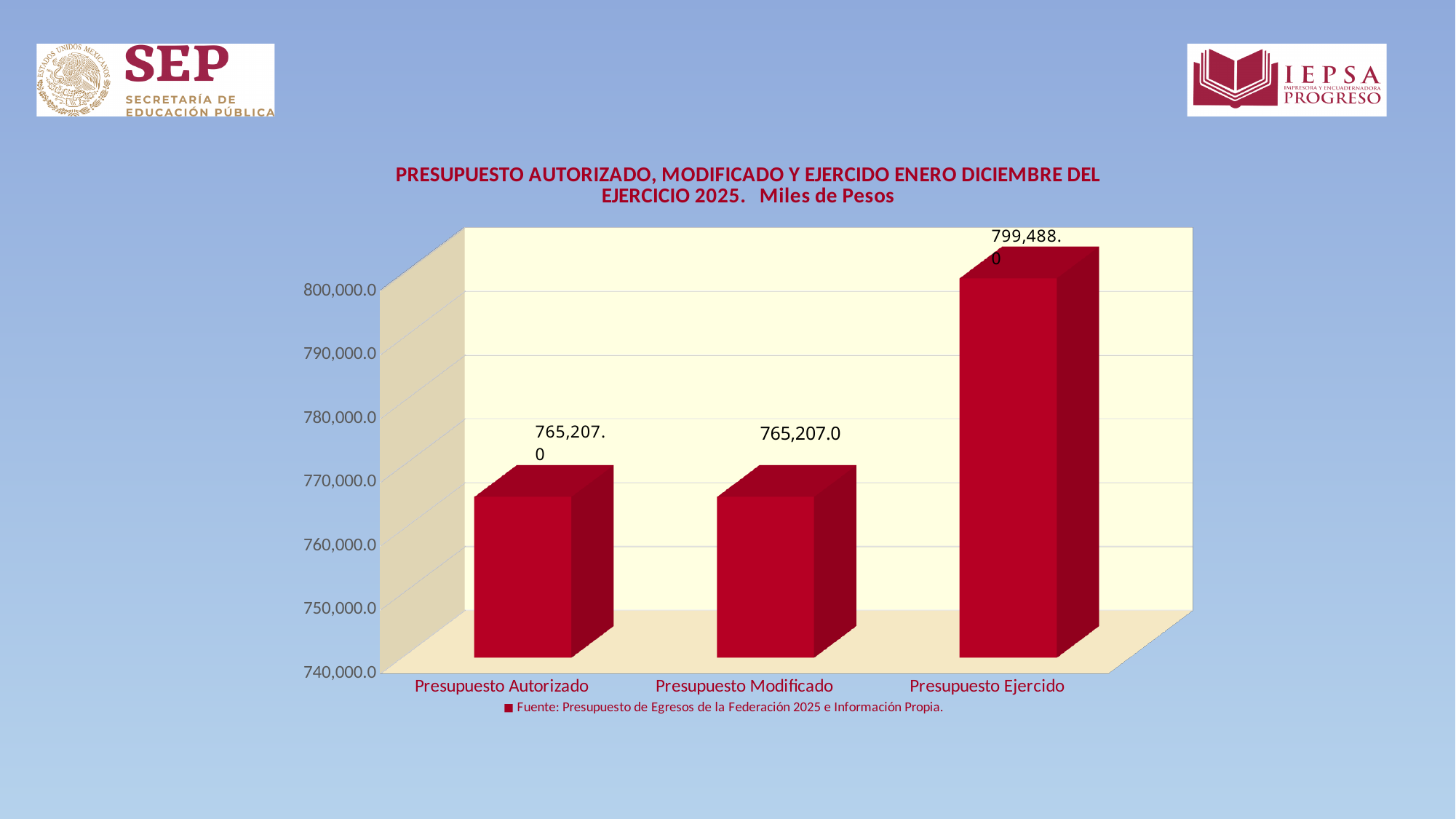
How many categories are shown on the x axis? 3 What is the difference between Presupuesto Modificado and Presupuesto Autorizado? 0.0 Is the value for Presupuesto Ejercido greater or less than 790,000.0? greater What is the value for Presupuesto Autorizado? 765,207.0 What kind of chart is shown on the slide? bar chart Is the value for Presupuesto Autorizado greater or less than 770,000.0? less What is the difference between Presupuesto Ejercido and Presupuesto Autorizado? 34,281.0 Which category has the highest value? Presupuesto Ejercido Which is larger, Presupuesto Ejercido or Presupuesto Modificado? Presupuesto Ejercido What is the value for Presupuesto Ejercido? 799,488.0 What is the value for Presupuesto Modificado? 765,207.0 In what unit are the values expressed according to the chart title? Miles de Pesos